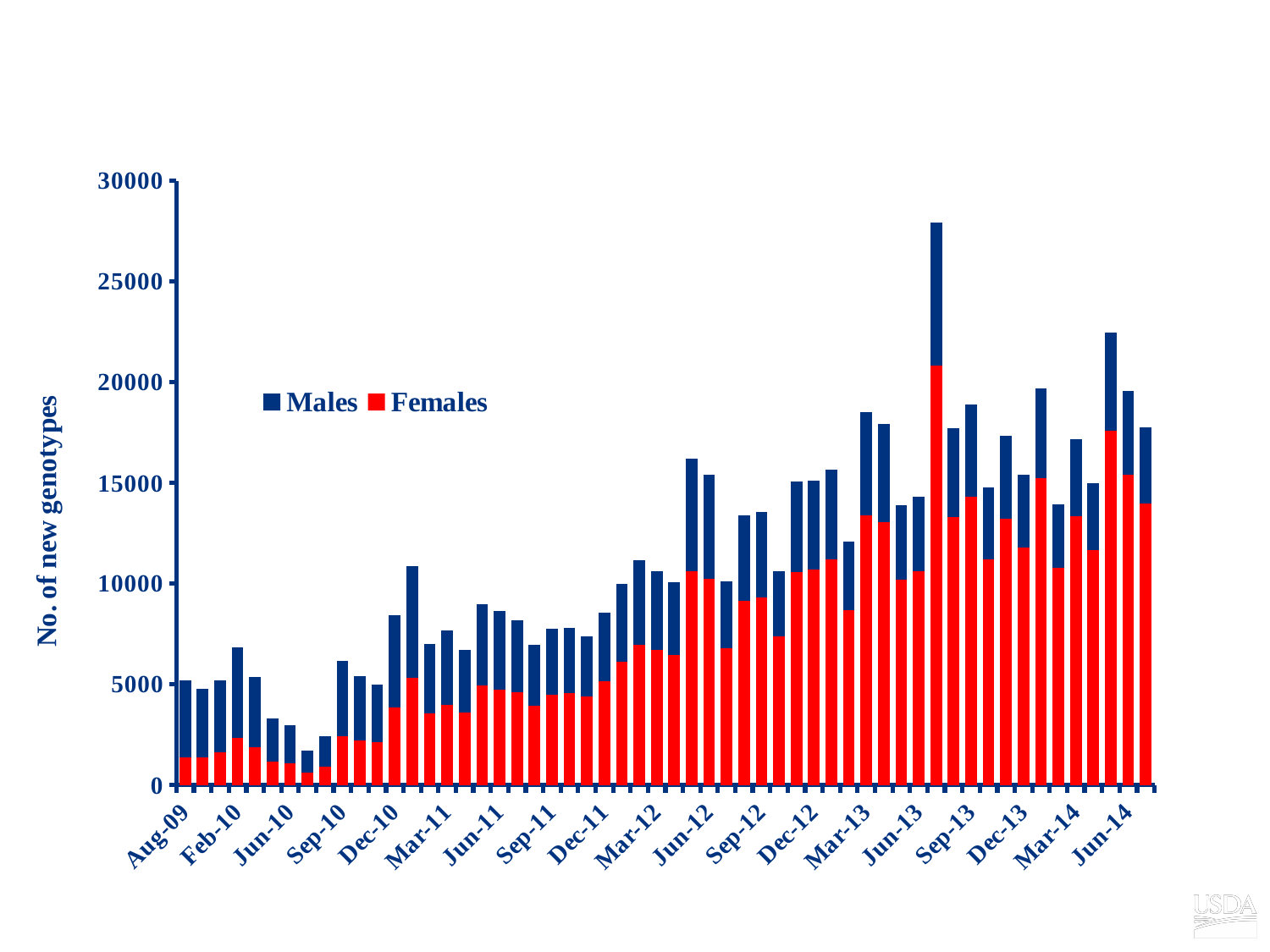
Is the Females value for Aug-09 greater or less than 5000? less Is the total for Aug-09 greater or less than 10000? less How many series does the legend list? 2 Do the bar totals generally rise or fall from Aug-09 to Jun-14? Rise What is the label on the vertical axis? No. of new genotypes What are the two series named in the legend? Males and Females Is the total of the tallest bar greater or less than 25000? greater Which colour represents Females in the chart? Red In the tallest bar, which series is larger, Males or Females? Females What kind of chart is shown on the slide? Stacked bar chart In the Aug-09 bar, which series is larger, Males or Females? Males